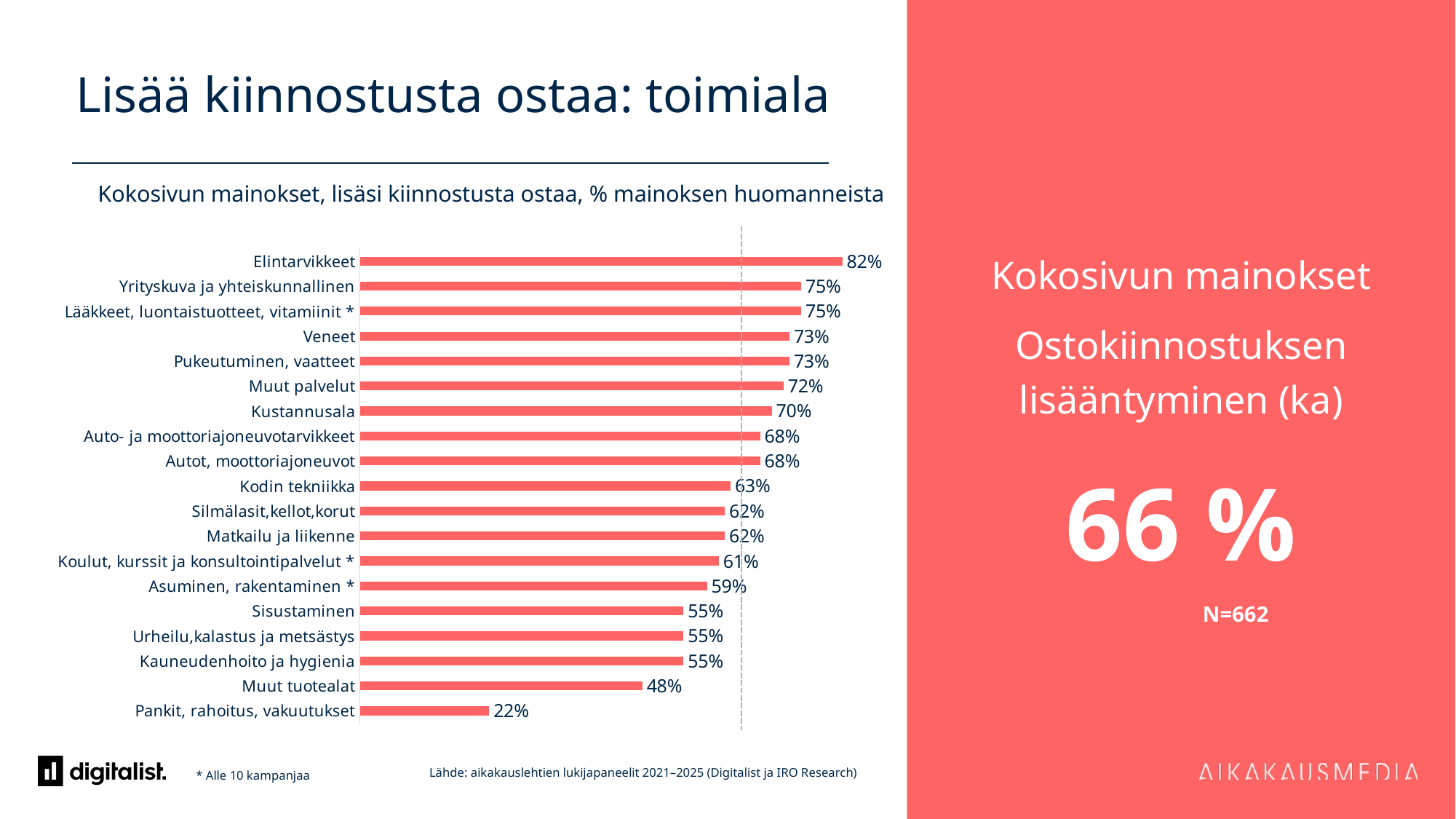
Which category has the highest value? Elintarvikkeet Which has a larger value, Kodin tekniikka or Muut tuotealat? Kodin tekniikka What is the value for Elintarvikkeet? 82% How many categories are shown in the bar chart? 19 What is the value for Kustannusala? 70% What is the difference between the values for Veneet and Sisustaminen? 18% Which category has the lowest value? Pankit, rahoitus, vakuutukset What is the average value (ka) shown in the red panel on the right? 66 % What is the value for Pankit, rahoitus, vakuutukset? 22% What is the value for Muut tuotealat? 48% What is the difference between the values for Elintarvikkeet and Pankit, rahoitus, vakuutukset? 60% What kind of chart is shown on the slide? Bar chart